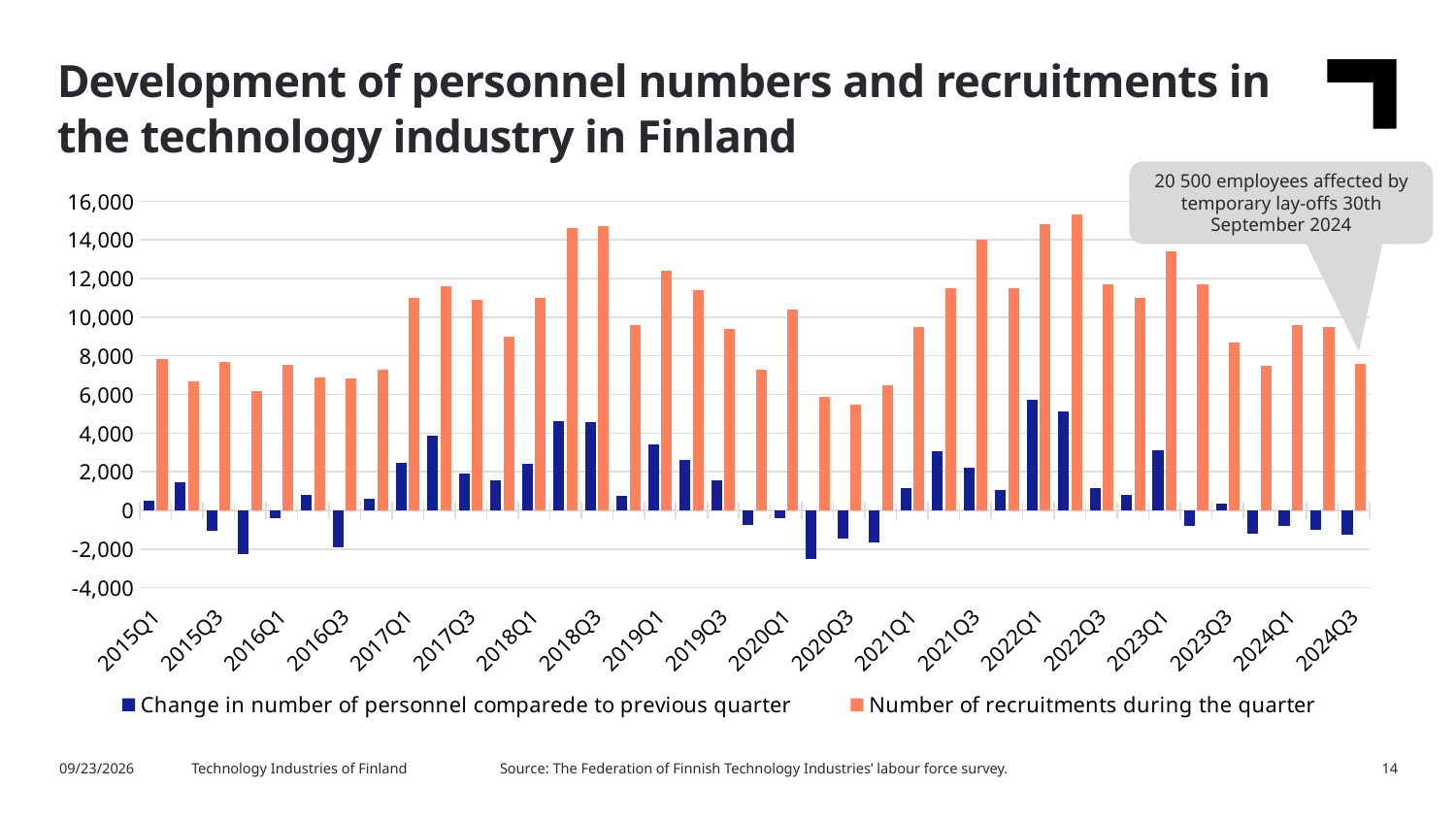
How many series does the legend list? 2 Is the number of recruitments during the quarter in 2018Q2 greater or less than 14,000? greater In which quarter is the change in number of personnel compared to previous quarter the highest? 2022Q1 Did the number of recruitments during the quarter generally rise or fall from 2020Q3 to 2022Q2? rise Is the change in number of personnel compared to previous quarter in 2022Q1 greater or less than 4,000? greater Is the number of recruitments during the quarter in 2020Q3 greater or less than 6,000? less Which quarter had more recruitments during the quarter, 2018Q2 or 2015Q1? 2018Q2 How many quarters are plotted on the x axis, from 2015Q1 to 2024Q3? 39 According to the callout on the chart, how many employees were affected by temporary lay-offs on 30th September 2024? 20 500 What kind of chart is shown on the slide? Bar chart